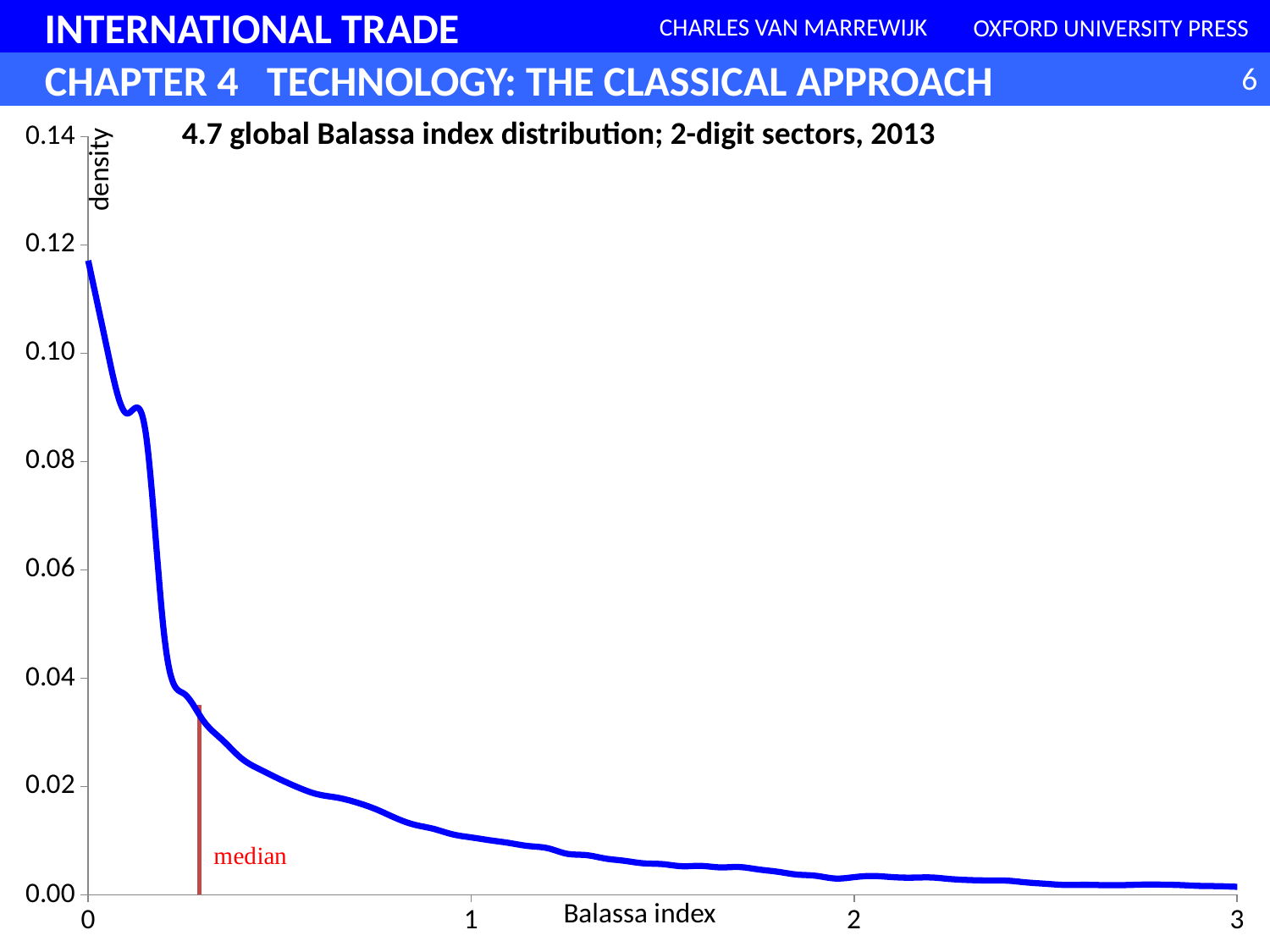
At which end of the x axis is the density highest, Balassa index 0 or Balassa index 3? Balassa index 0 Is the density at a Balassa index of 3 greater or less than 0.02? less Is the density at a Balassa index of 1 greater or less than 0.02? less Is the Balassa index value marked by the red median line greater or less than 1? less What is the label of the x axis? Balassa index Does the density rise or fall as the Balassa index increases from 0 to 3? fall What kind of chart is shown on the slide? line chart What is the title of the chart? 4.7 global Balassa index distribution; 2-digit sectors, 2013 What is the highest value shown on the y axis? 0.14 Which has the higher density: a Balassa index of 1 or a Balassa index of 2? Balassa index of 1